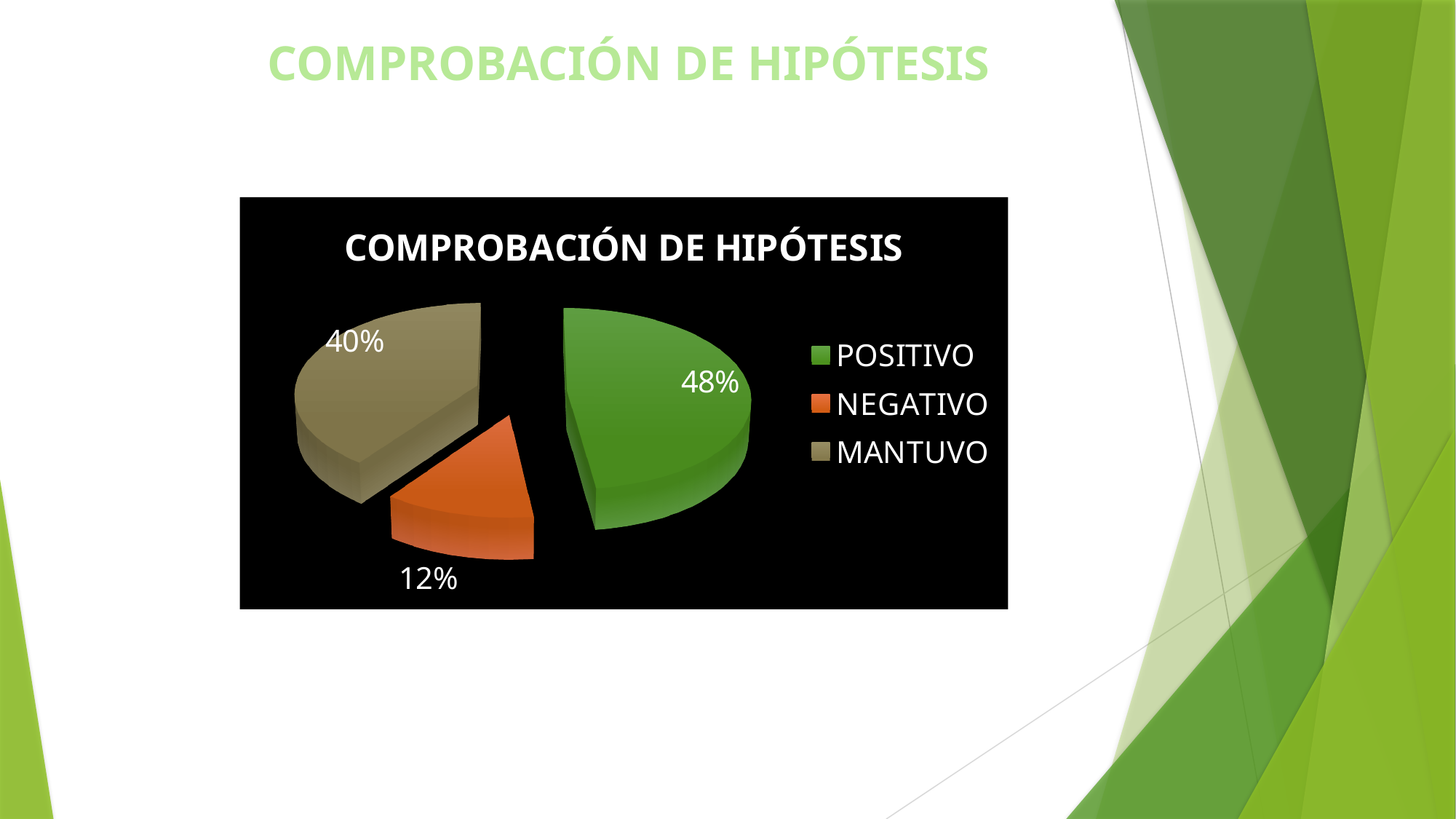
What colour is the slice for NEGATIVO? Orange How many categories does the legend list? 3 What type of chart is shown on the slide? Pie chart What is the difference in percentage points between MANTUVO and NEGATIVO? 28 Which category has the smallest share of the pie? NEGATIVO What percentage is shown for NEGATIVO? 12% What percentage is shown for POSITIVO? 48% What percentage is shown for MANTUVO? 40% What is the difference in percentage points between POSITIVO and MANTUVO? 8 Which is larger, the share for MANTUVO or the share for NEGATIVO? MANTUVO What is the title of the chart? COMPROBACIÓN DE HIPÓTESIS Which category has the largest share of the pie? POSITIVO